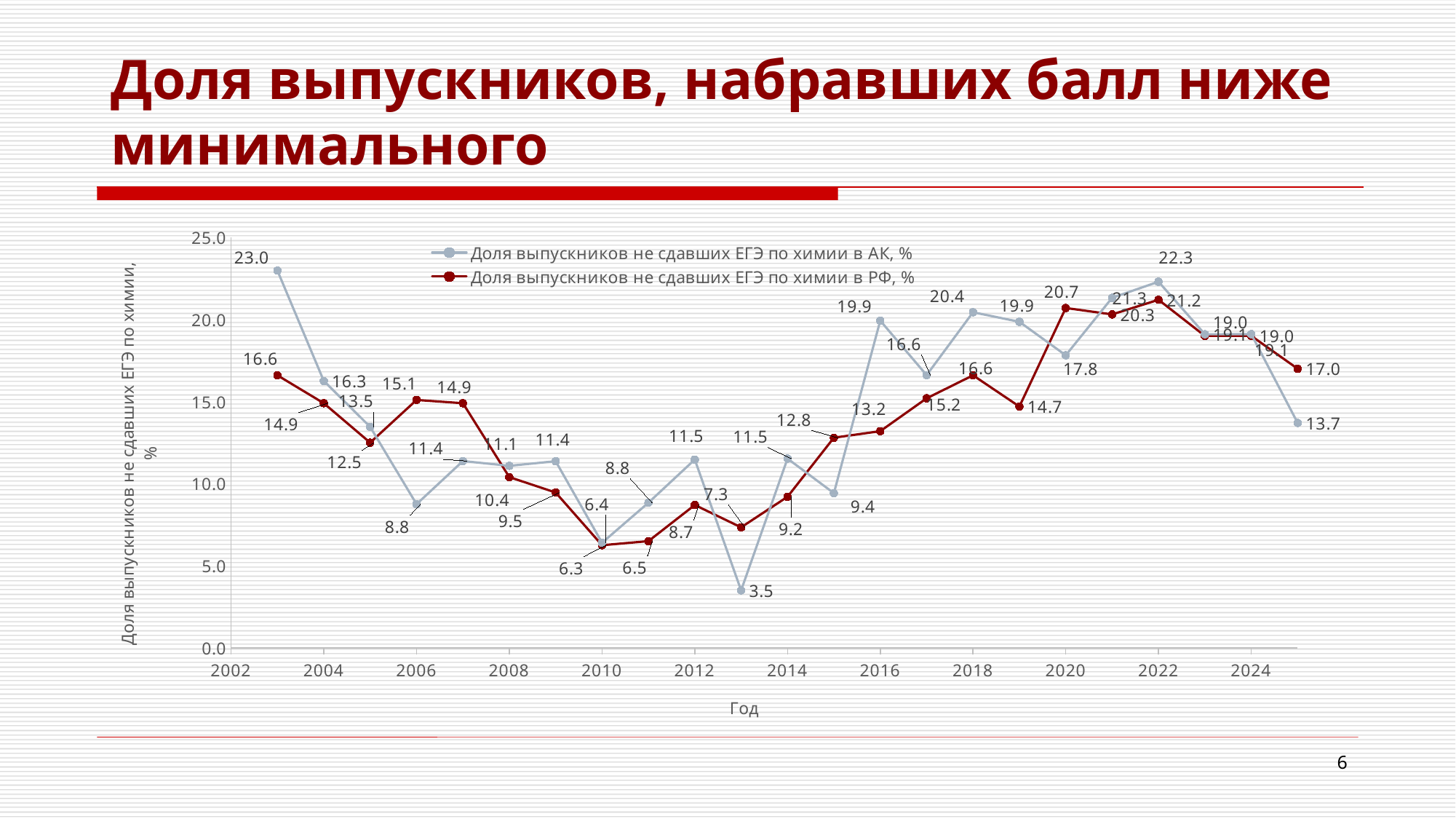
In which year is the РФ (red) series at its highest? 2022 In which year is the АК (grey) series at its highest? 2003 What is the difference between the РФ and АК values in 2025? 3.3 What kind of chart is shown on the slide? line chart What is the title of the x axis? Год How many series does the legend list? 2 In 2003, which series has the larger value, АК or РФ? АК What is the value for АК (grey series) in 2013? 3.5 What is the value for РФ (red series) in 2020? 20.7 What is the value for АК (grey series) in 2003? 23.0 In which year is the АК (grey) series at its lowest? 2013 What is the value for РФ (red series) in 2025? 17.0